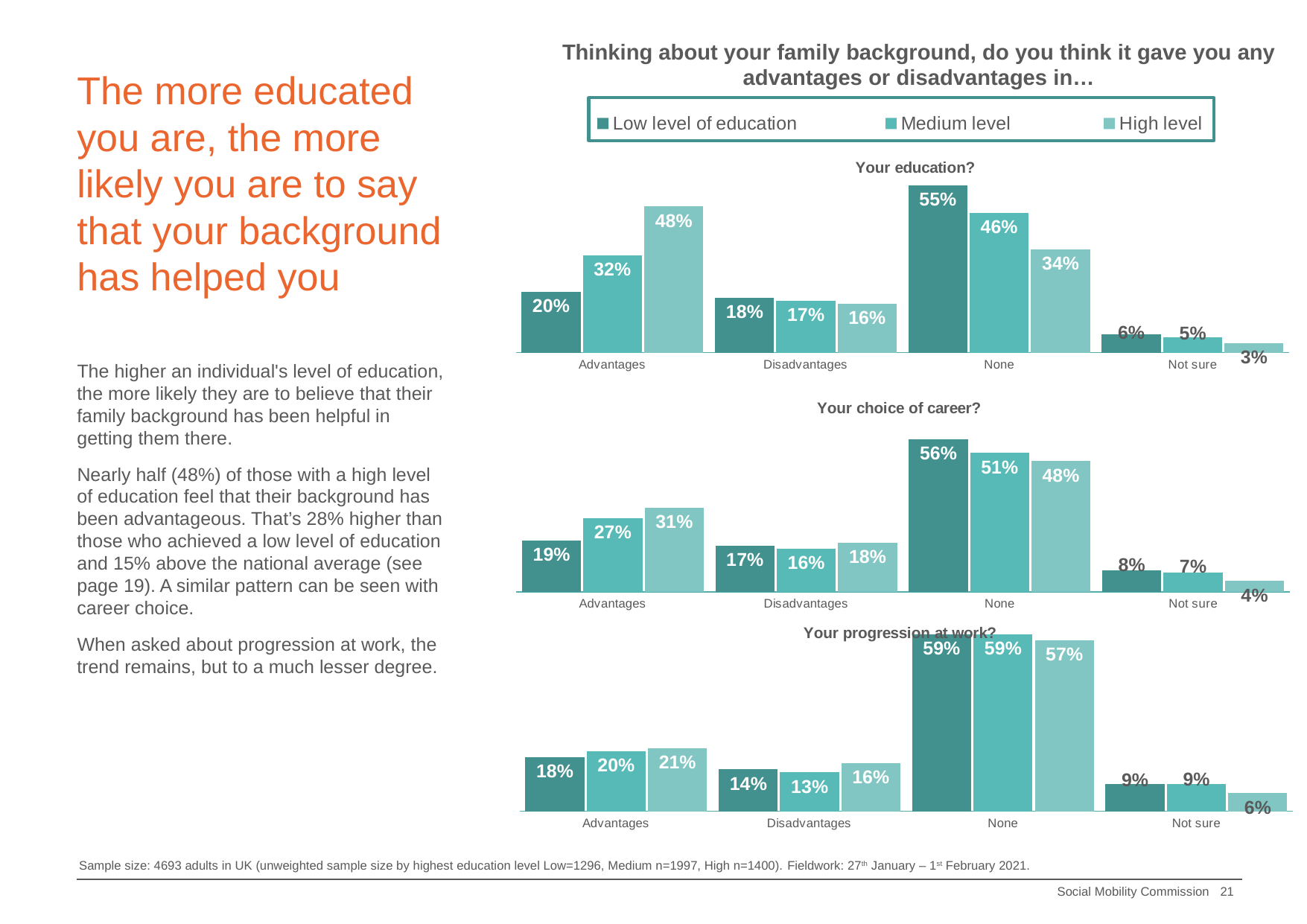
In the 'Your progression at work?' chart, what is the value for High level in the Not sure category? 6% In the 'Your choice of career?' chart, which category has the lowest value for High level? Not sure How many categories are shown on the x axis of the 'Your progression at work?' chart? 4 In the 'Your education?' chart, which category has the highest value for Low level of education? None How many series does the legend list? 3 In the 'Your choice of career?' chart, what is the value for Medium level in the Advantages category? 27% In the 'Your education?' chart, what is the value for Low level of education in the None category? 55% In the 'Your education?' chart, what is the difference between the High level and Low level of education values for Advantages? 28% In the 'Your choice of career?' chart, which is larger for None: Low level of education or High level? Low level of education In the 'Your progression at work?' chart, what is the difference between the Low level of education and Medium level values for Disadvantages? 1% What kind of chart is the 'Your choice of career?' chart? Bar chart In the 'Your education?' chart, what is the value for High level in the Advantages category? 48%